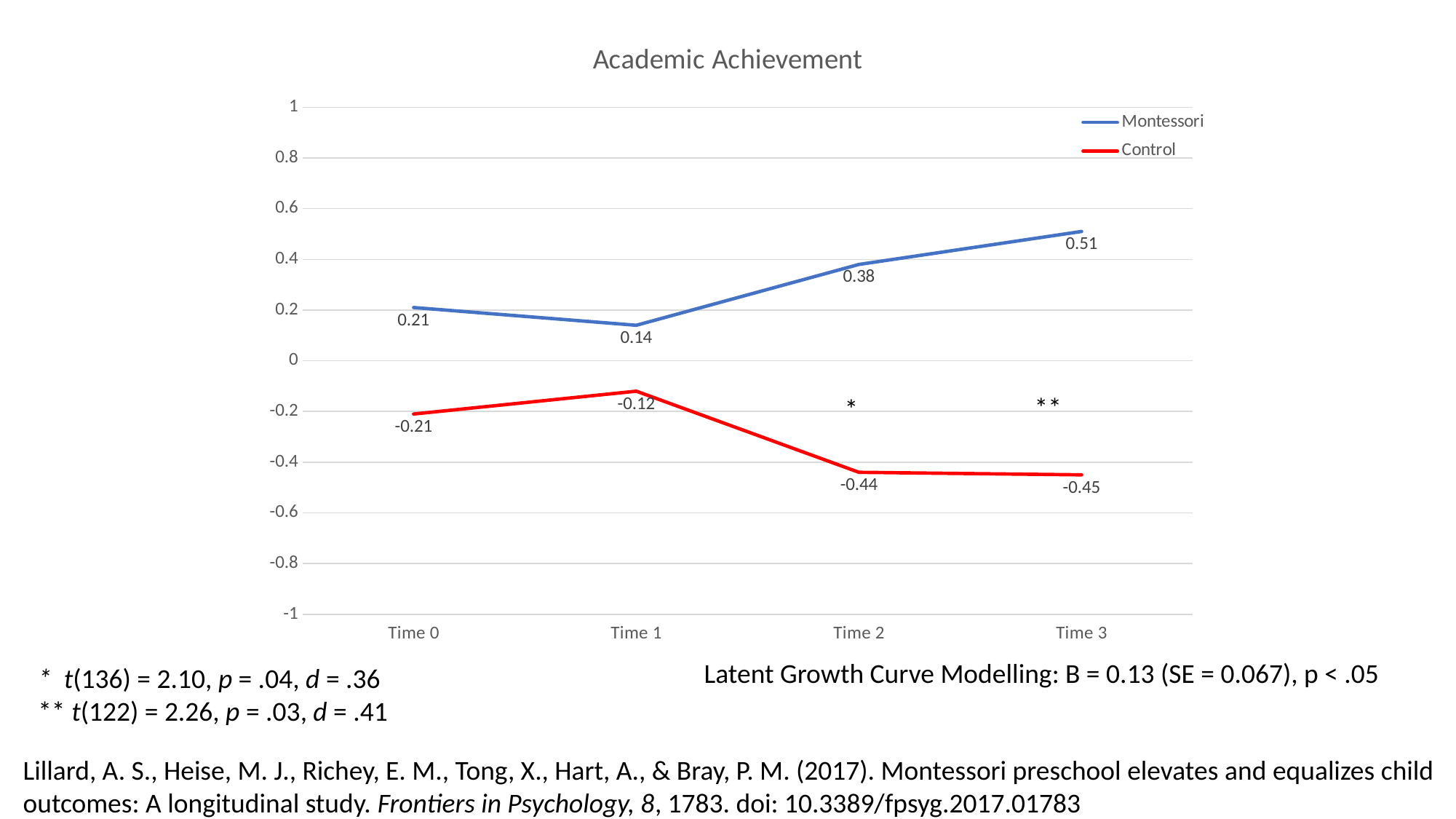
What is the Control value at Time 2? -0.44 How many series does the legend list? 2 At which time point is the Control value highest? Time 1 What is the title of the chart? Academic Achievement Which series has the larger value at Time 2, Montessori or Control? Montessori What is the difference between the Montessori and Control values at Time 3? 0.96 What is the Control value at Time 0? -0.21 What kind of chart is shown? Line chart How many time points are plotted on the x axis? 4 At which time point is the Montessori value highest? Time 3 What is the Montessori value at Time 1? 0.14 What is the Montessori value at Time 3? 0.51